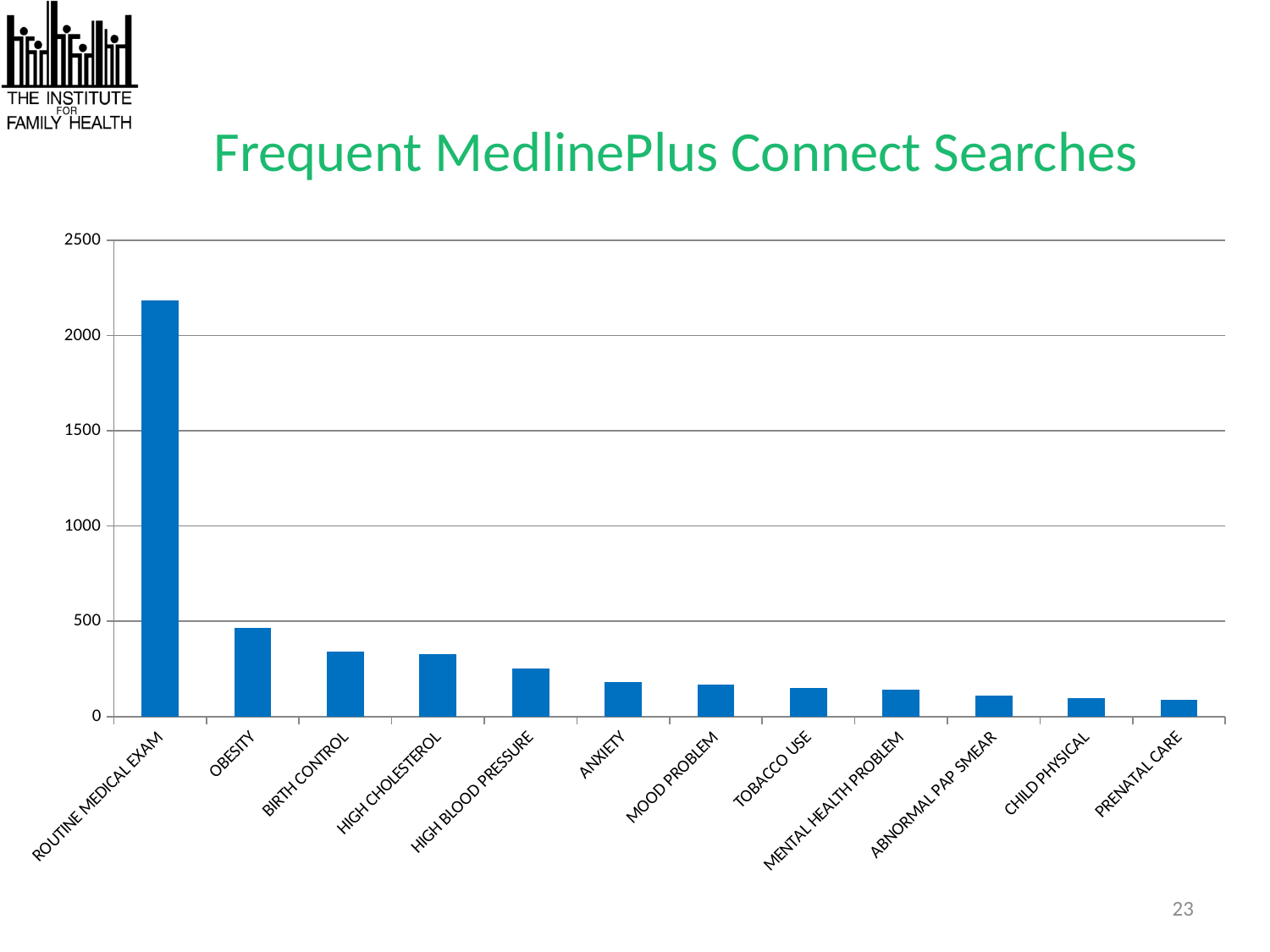
Do the values generally rise or fall moving from left to right along the x axis? fall Which category has the highest value in the chart? ROUTINE MEDICAL EXAM Is the value for HIGH BLOOD PRESSURE greater or less than 500? less Which has a larger value, OBESITY or PRENATAL CARE? OBESITY Is the value for OBESITY greater or less than 500? less Which has a larger value, ROUTINE MEDICAL EXAM or OBESITY? ROUTINE MEDICAL EXAM Which has a larger value, HIGH BLOOD PRESSURE or TOBACCO USE? HIGH BLOOD PRESSURE What is the title of the chart? Frequent MedlinePlus Connect Searches How many categories are shown on the x axis of the chart? 12 What kind of chart is shown on the slide? bar chart Is the value for BIRTH CONTROL greater or less than 500? less